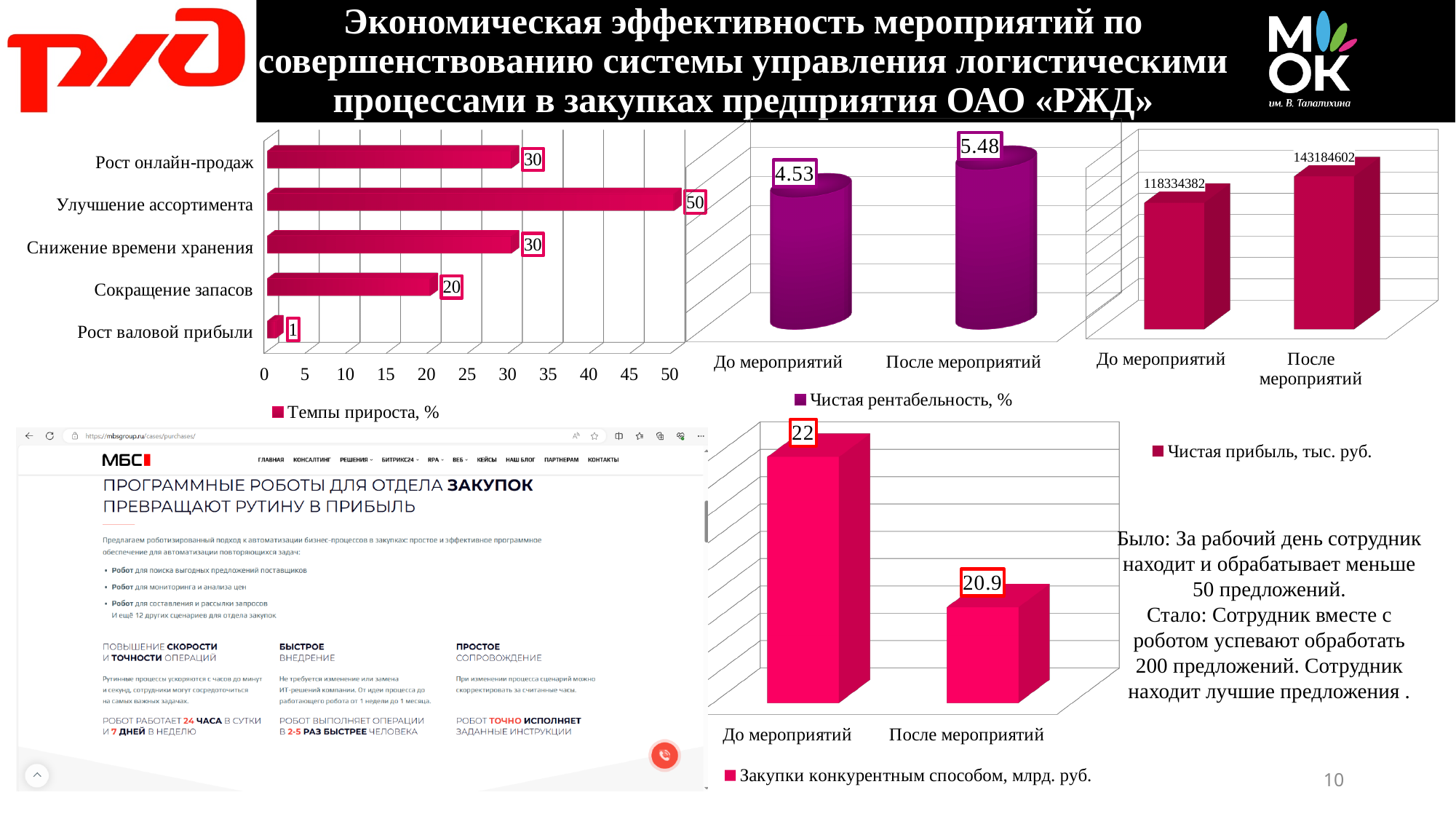
How many categories are shown in the top-left bar chart (Темпы прироста, %)? 5 In the chart labelled Чистая прибыль, тыс. руб., what is the value for До мероприятий? 118334382 In the bottom chart labelled Закупки конкурентным способом, млрд. руб., do the values rise or fall from До мероприятий to После мероприятий? fall In the top-left bar chart (Темпы прироста, %), which category has the highest value? Улучшение ассортимента In the top-left bar chart (Темпы прироста, %), what is the difference between Улучшение ассортимента and Сокращение запасов? 30 In the chart labelled Чистая прибыль, тыс. руб., which is larger: До мероприятий or После мероприятий? После мероприятий In the chart labelled Чистая рентабельность, %, what is the difference between После мероприятий and До мероприятий? 0.95 In the top-left bar chart (Темпы прироста, %), which category has the lowest value? Рост валовой прибыли In the top-left bar chart (Темпы прироста, %), what is the value for Улучшение ассортимента? 50 In the bottom chart labelled Закупки конкурентным способом, млрд. руб., what is the value for После мероприятий? 20.9 In the chart labelled Чистая рентабельность, %, what is the value for После мероприятий? 5.48 What kind of chart is the top-left chart labelled Темпы прироста, %? bar chart